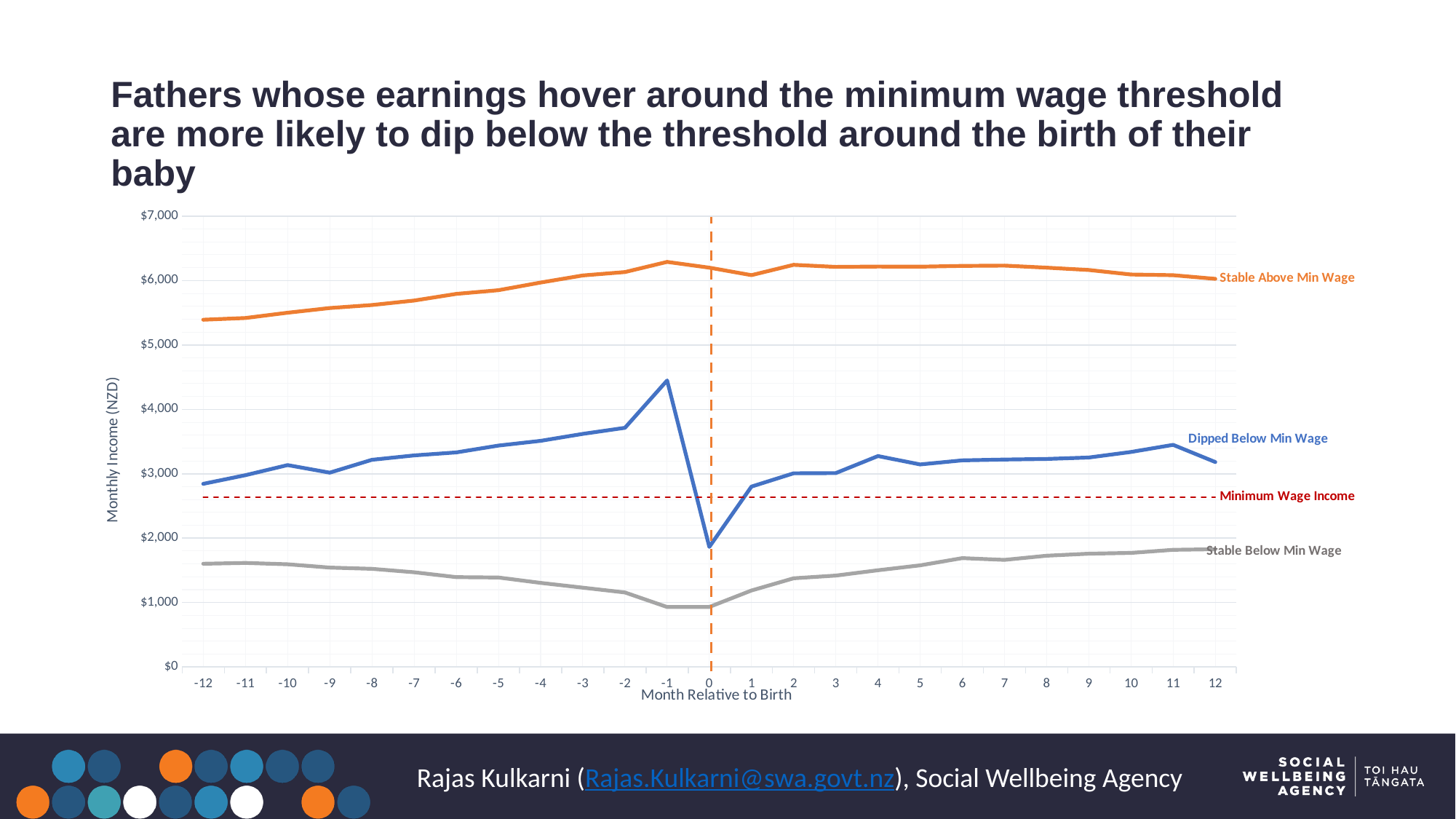
What is the title of the x axis of the chart? Month Relative to Birth Does the Stable Above Min Wage series rise or fall from month -12 to month -1? rise Is the value for Stable Below Min Wage at month 12 greater or less than $2,000? less How many months are plotted along the x axis of the chart? 25 Is the value for Stable Above Min Wage at month -12 greater or less than $5,000? greater At which month relative to birth does the Dipped Below Min Wage series reach its lowest value? 0 At which month relative to birth does the Dipped Below Min Wage series reach its highest value? -1 How many income series (excluding the Minimum Wage Income reference line) are plotted in the chart? 3 Which series has the highest monthly income across the whole chart? Stable Above Min Wage What kind of chart is shown on the slide? Line chart Is the value for Dipped Below Min Wage at month -1 greater or less than $4,000? greater Which series has the lowest monthly income across the whole chart? Stable Below Min Wage